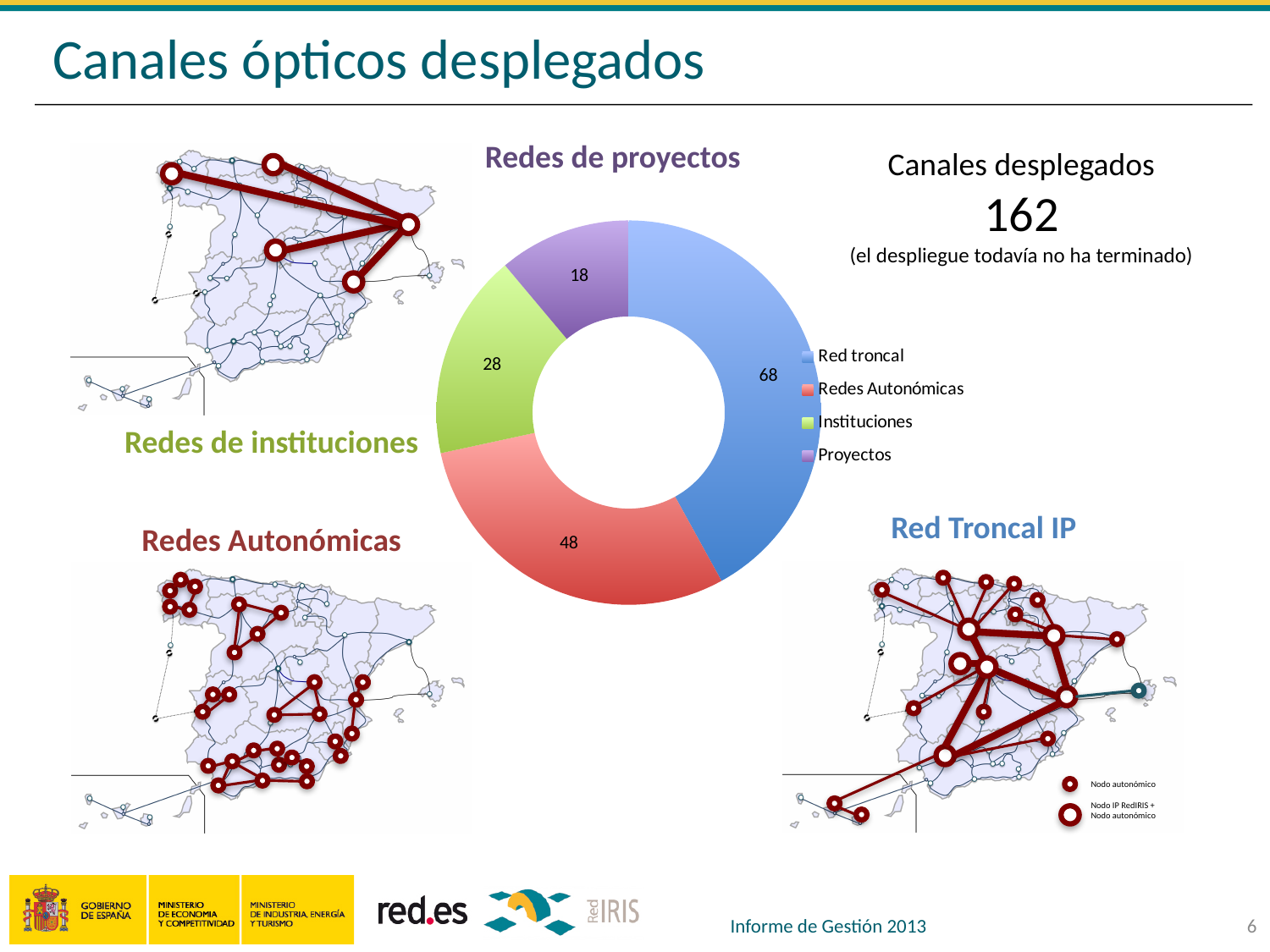
What kind of chart is used to show the canales desplegados? Donut chart What is the total of all the values in the donut chart? 162 What value is shown for Instituciones in the donut chart? 28 What is the difference between the values for Red troncal and Redes Autonómicas? 20 What is the difference between the values for Instituciones and Proyectos? 10 Which is larger in the donut chart, Redes Autonómicas or Instituciones? Redes Autonómicas What value is shown for Proyectos in the donut chart? 18 How many categories does the donut chart show? 4 Which category has the smallest value in the donut chart? Proyectos Which category has the largest value in the donut chart? Red troncal What value is shown for Redes Autonómicas in the donut chart? 48 What value is shown for Red troncal in the donut chart? 68